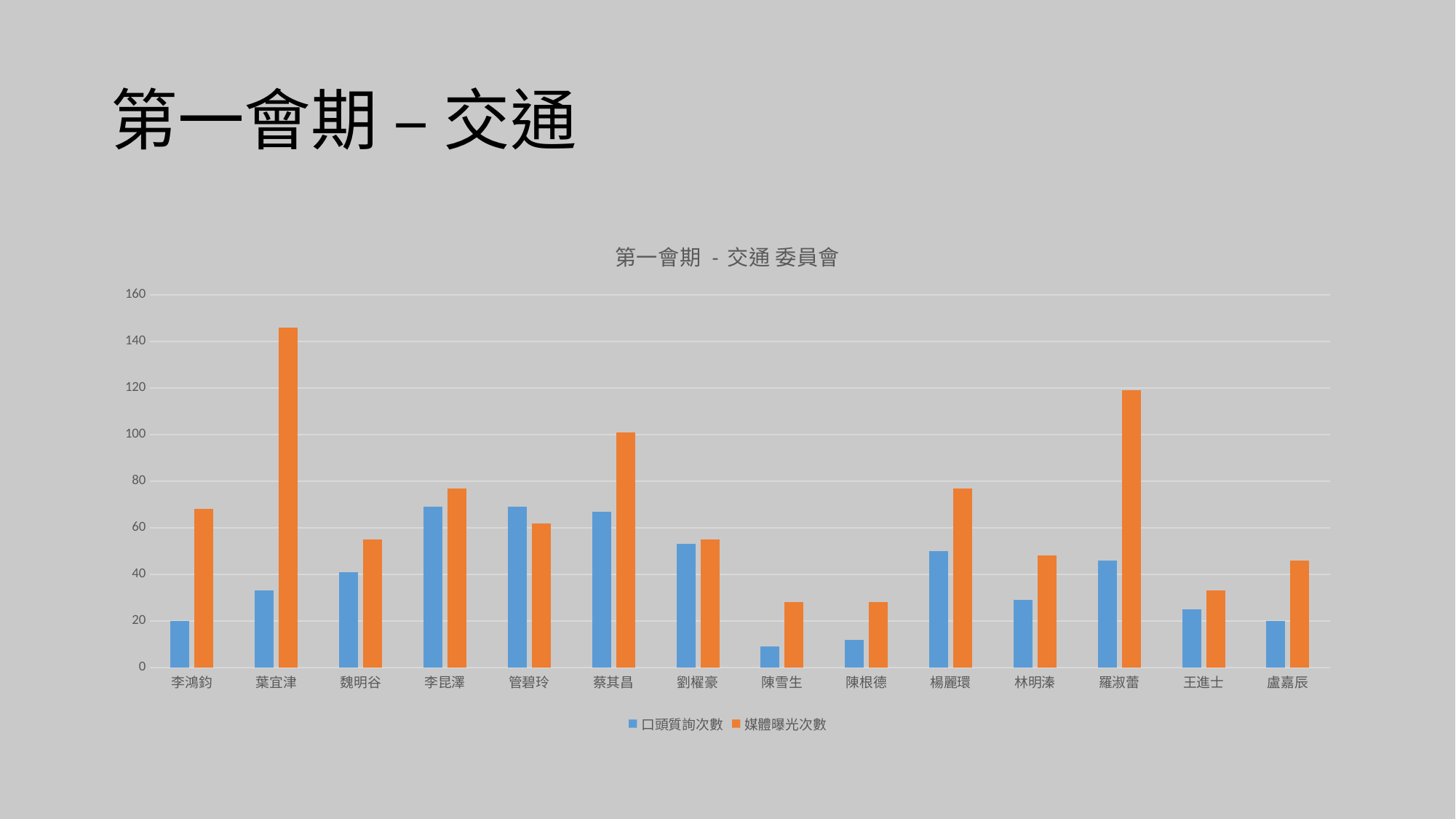
Which legislator has the larger 媒體曝光次數: 葉宜津 or 羅淑蕾? 葉宜津 Is the 口頭質詢次數 value for 陳雪生 greater or less than 20? less Which is larger for 蔡其昌: 口頭質詢次數 or 媒體曝光次數? 媒體曝光次數 What is the title of the chart? 第一會期 - 交通 委員會 How many legislators (categories) are shown on the x axis? 14 Is the 媒體曝光次數 value for 林明溱 greater or less than 40? greater Which legislator has the lowest 口頭質詢次數? 陳雪生 Is the 媒體曝光次數 value for 葉宜津 greater or less than 140? greater How many series does the legend list? 2 Which legislator has the highest 媒體曝光次數? 葉宜津 What kind of chart is shown on the slide? bar chart